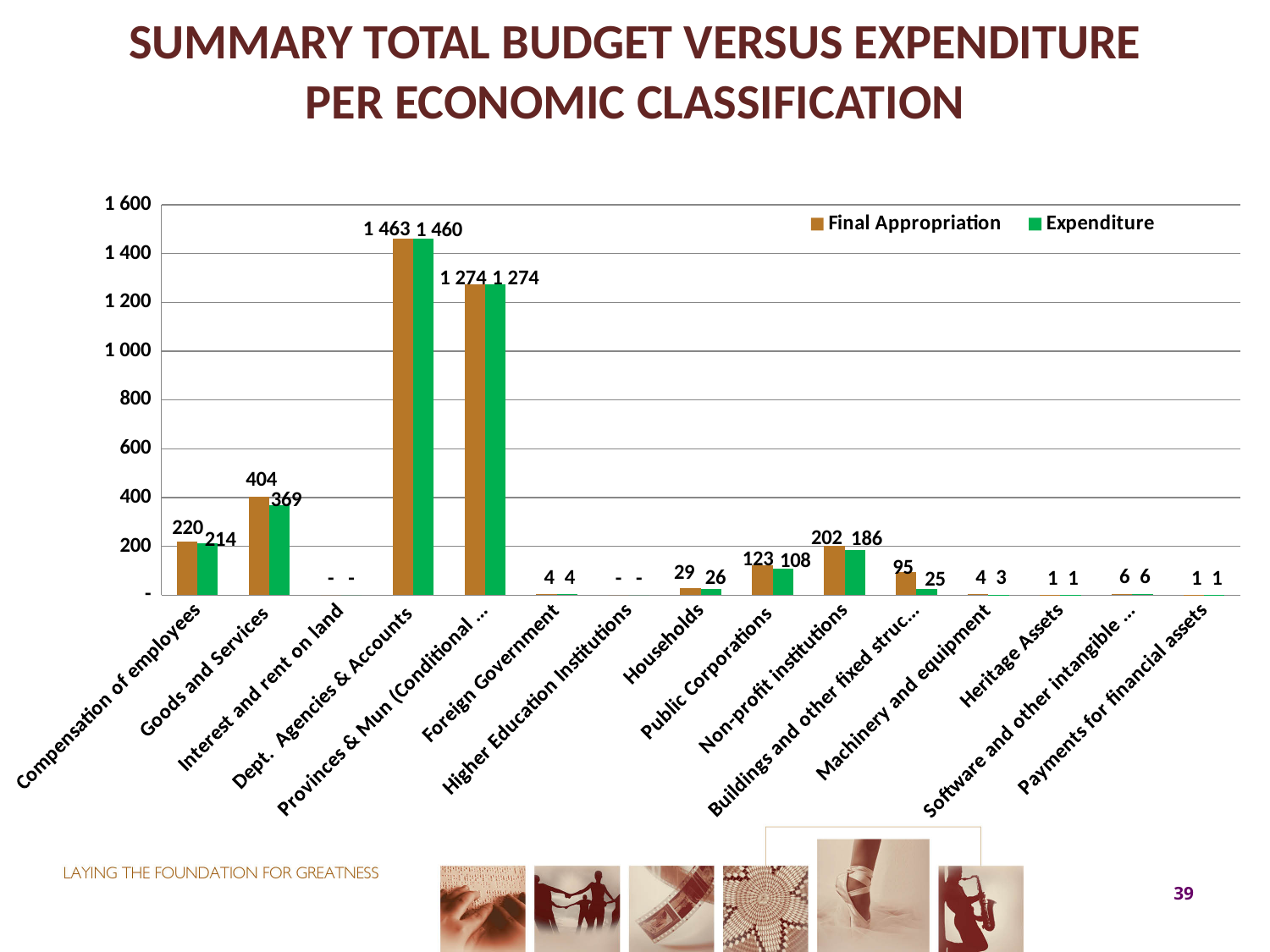
How many series does the legend list? 2 What is the difference between Final Appropriation and Expenditure for Goods and Services? 35 What is the difference between Final Appropriation and Expenditure for Non-profit institutions? 16 What is the Expenditure value for Public Corporations? 108 How many categories are shown on the x axis? 15 Is the Expenditure value for Dept. Agencies & Accounts greater or less than 1 400? greater What is the Expenditure value for Buildings and other fixed structures? 25 What kind of chart is shown on the slide? Bar chart Which series is shown in green in the legend? Expenditure Which category has the highest Final Appropriation? Dept. Agencies & Accounts Which is larger, the Final Appropriation for Compensation of employees or the Final Appropriation for Public Corporations? Compensation of employees What is the Final Appropriation value for Goods and Services? 404